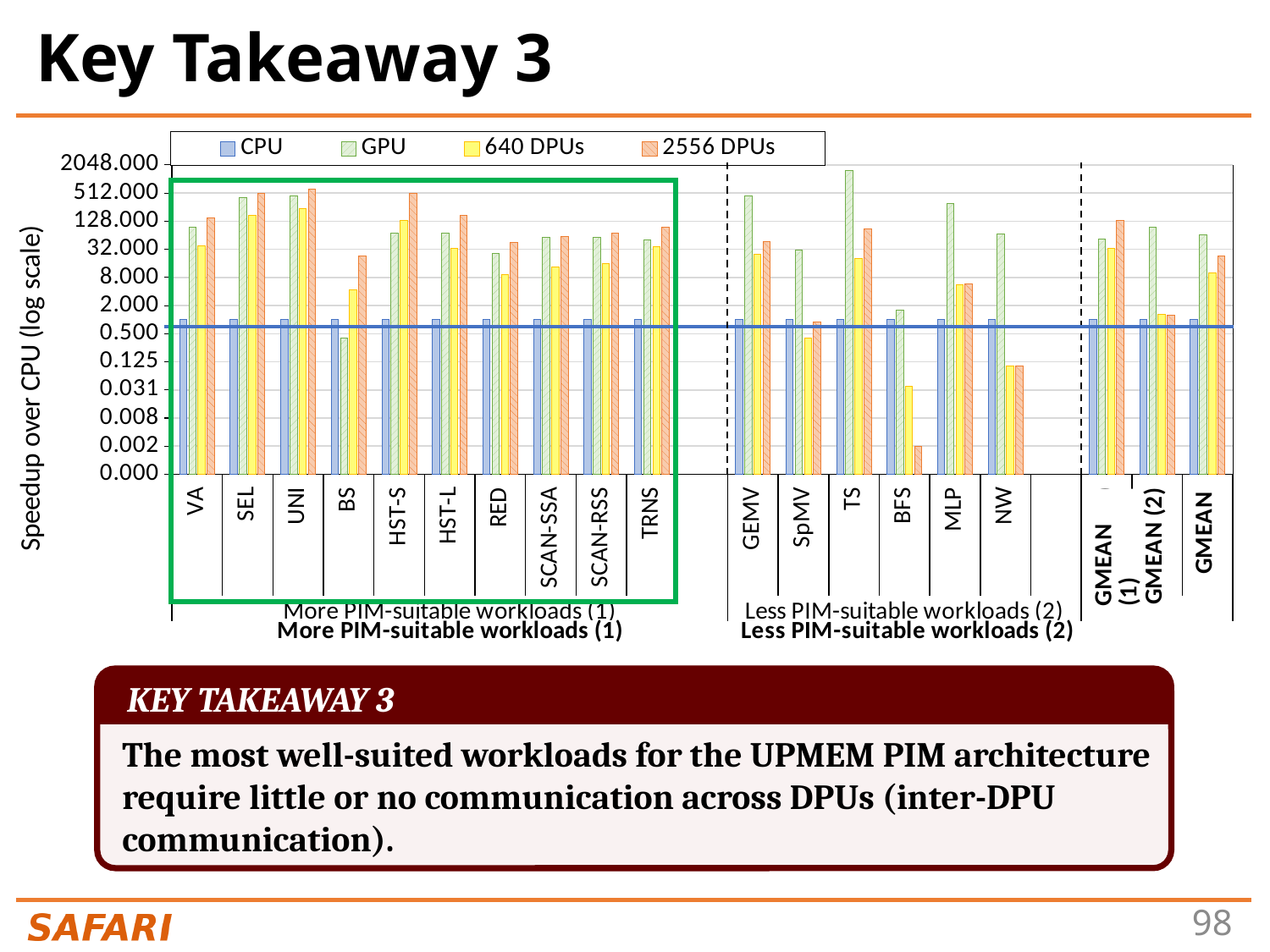
For VA, which is larger: the GPU value or the 640 DPUs value? GPU What is the label of the y axis? Speedup over CPU (log scale) Is the GPU value for TS greater or less than 512.000? greater For BS, which is larger: the GPU value or the 2556 DPUs value? 2556 DPUs What kind of chart is shown on the slide? bar chart For BFS, which series has the lowest value? 2556 DPUs How many workload categories are shown on the x axis, including the GMEAN entries? 19 How many series does the legend list? 4 Is the 2556 DPUs value for UNI greater or less than 512.000? greater Is the 640 DPUs value for NW greater or less than 0.500? less What are the series listed in the legend? CPU, GPU, 640 DPUs, 2556 DPUs